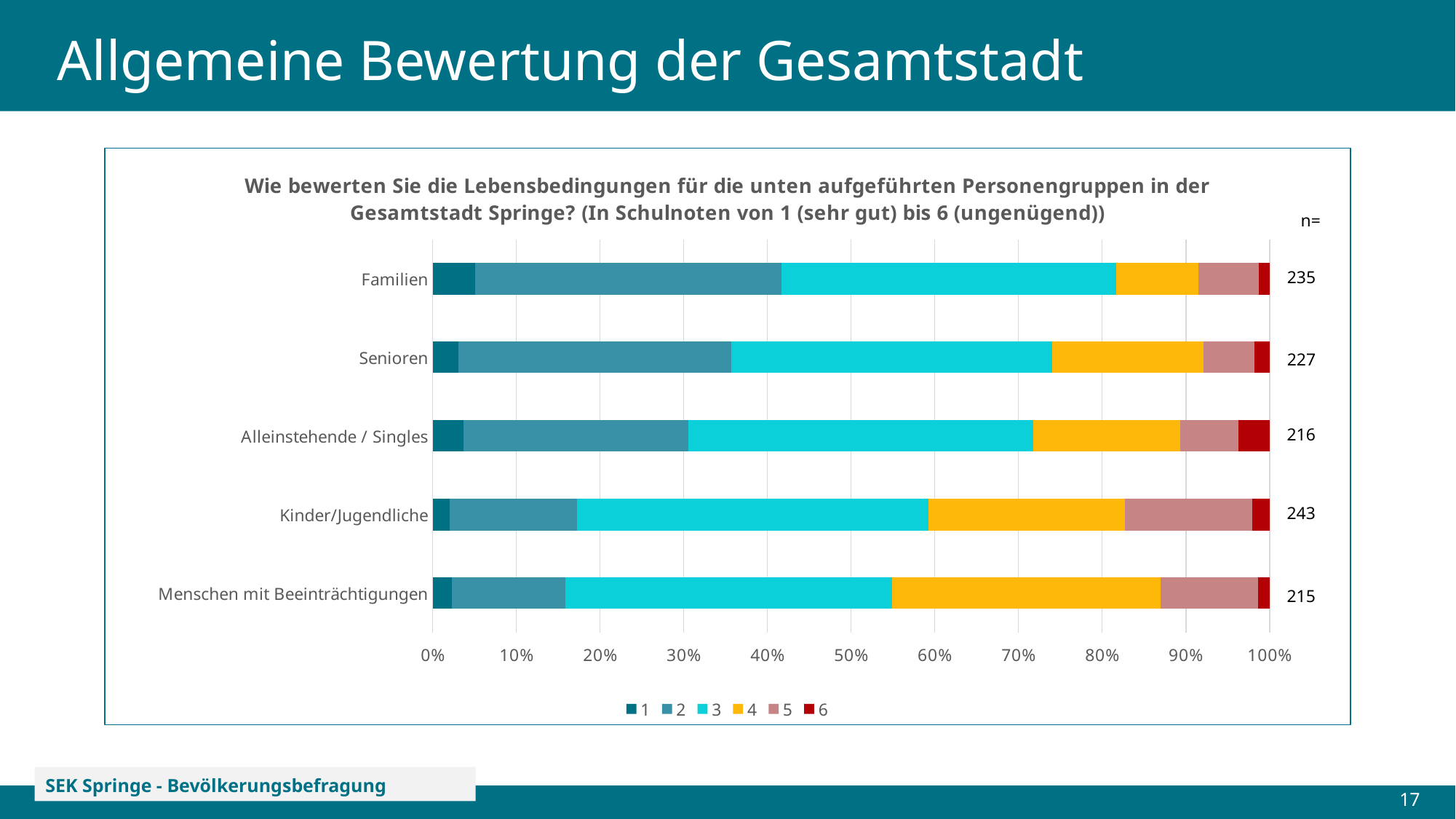
How many person groups (categories) are plotted in the chart? 5 Which legend entry is shown in dark red? 6 What is the difference between the n values for Kinder/Jugendliche and Menschen mit Beeinträchtigungen? 28 Is the combined share of grades 1 and 2 for Familien greater or less than 40%? greater What kind of chart is shown on the slide? Stacked bar chart Which group has the larger share of grade 4 (yellow segment): Familien or Menschen mit Beeinträchtigungen? Menschen mit Beeinträchtigungen Which person group has the lowest n value? Menschen mit Beeinträchtigungen Which person group has the highest n value? Kinder/Jugendliche What is the n value shown for Familien? 235 Is the combined share of grades 1 to 3 for Kinder/Jugendliche greater or less than 70%? less How many series does the legend list? 6 What is the n value shown for Alleinstehende / Singles? 216